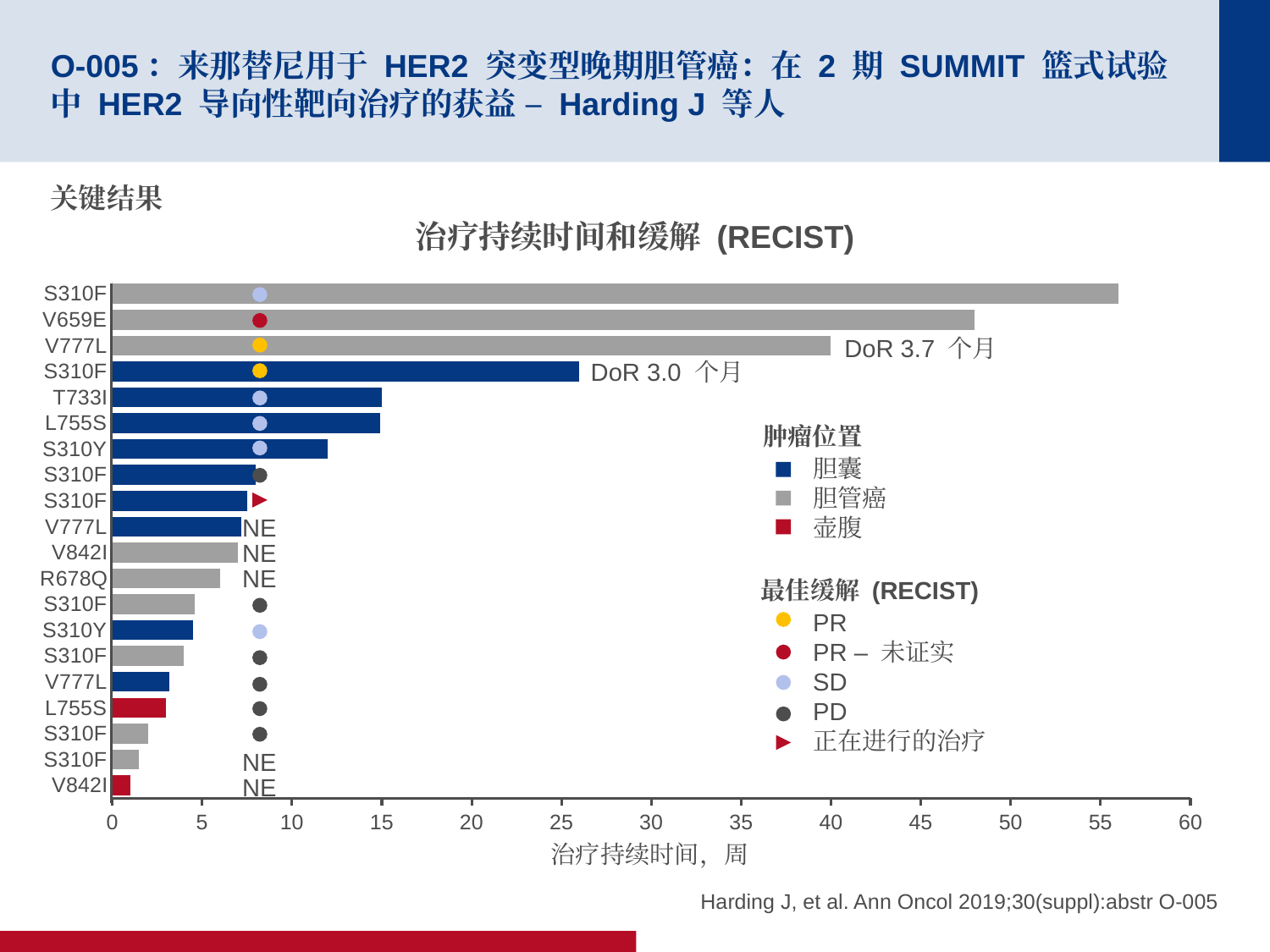
How many patient bars are plotted in the chart? 20 How many tumour locations are listed in the 肿瘤位置 legend? 3 Which has the longer treatment duration, V659E or the gray V777L bar? V659E Is the treatment duration of the red L755S bar greater or less than 5 weeks? less What kind of chart is shown on the slide? bar chart What is the x-axis label of the chart? 治疗持续时间，周 What DoR value is printed next to the blue S310F bar? DoR 3.0 个月 Is the treatment duration for V659E greater or less than 45 weeks? greater Which mutation label is on the shortest bar (shortest treatment duration)? V842I Is the treatment duration of the top S310F bar greater or less than 50 weeks? greater Which mutation label is on the longest bar (longest treatment duration)? S310F How many entries are listed in the 最佳缓解 (RECIST) legend? 5